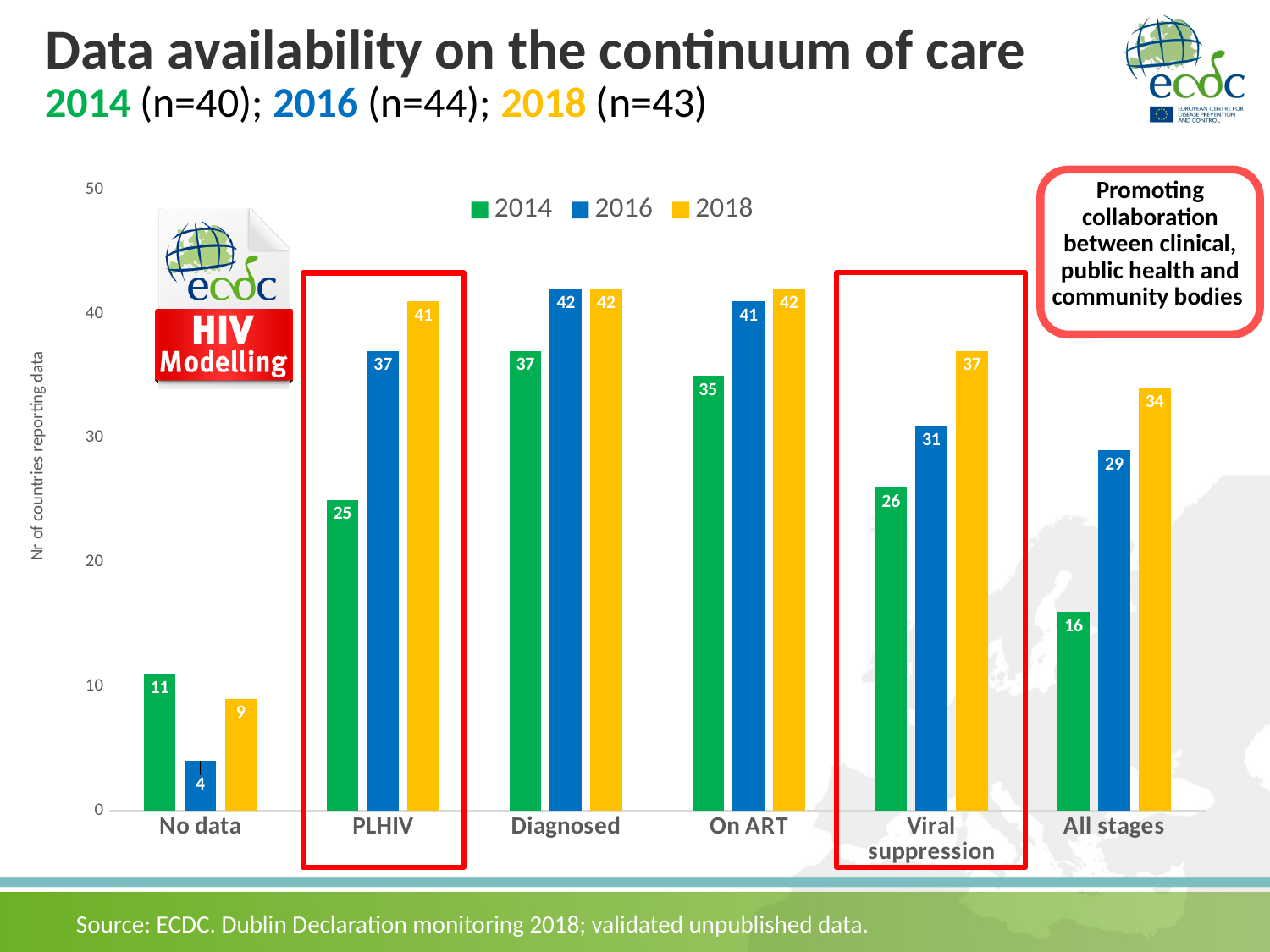
What is the value for No data in 2016? 4 What is the label of the vertical axis? Nr of countries reporting data What kind of chart is shown on the slide? bar chart Is the value for On ART in 2014 greater or less than 30? greater What is the value for PLHIV in 2018? 41 Which category has the highest value in the 2014 series? Diagnosed Which is larger for Viral suppression: the 2016 value or the 2018 value? 2018 Which category has the lowest value in the 2018 series? No data How many categories are shown on the x axis? 6 How many series does the legend list? 3 What is the difference between the 2018 and 2014 values for All stages? 18 What is the value for Viral suppression in 2014? 26